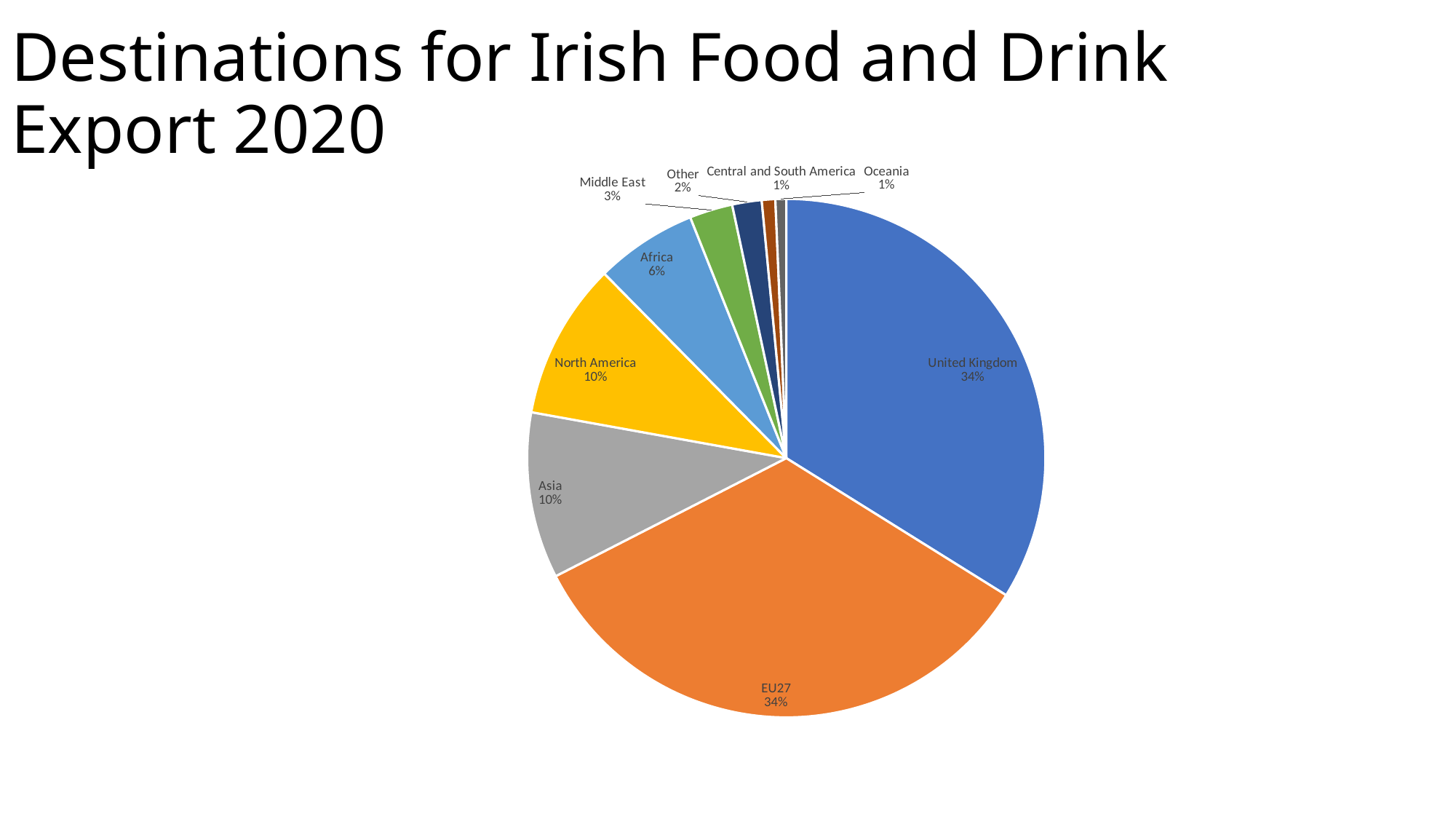
What percentage of exports went to Asia? 10% What share of Irish food and drink exports in 2020 went to the United Kingdom? 34% What share of exports went to Africa? 6% What percentage is shown for Oceania? 1% How many destination categories are shown in the pie chart? 9 What percentage is shown for the Middle East? 3% What percentage of exports went to North America? 10% What share of exports went to EU27? 34% What type of chart is shown on the slide? pie chart What is the difference in percentage points between the United Kingdom share and the Africa share? 28 What is the title of the chart on the slide? Destinations for Irish Food and Drink Export 2020 Which is larger, the share for Africa or the share for the Middle East? Africa